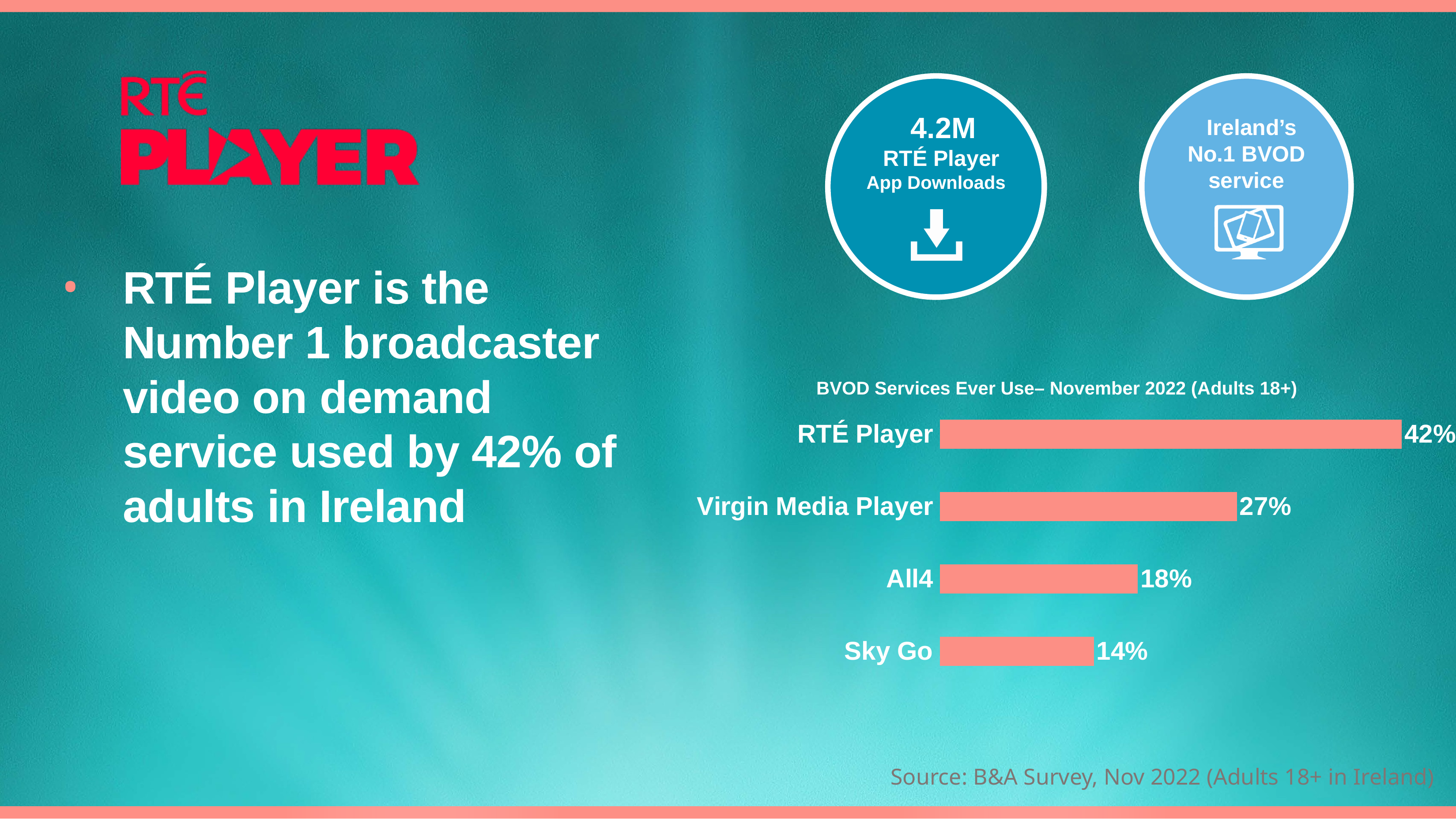
What is the title of the chart on the slide? BVOD Services Ever Use– November 2022 (Adults 18+) Which BVOD service has the highest ever-use value in the chart? RTÉ Player What is the value for RTÉ Player in the BVOD Services Ever Use chart? 42% What is the difference between the values for All4 and Sky Go? 4% What kind of chart is shown on the slide? Bar chart Which BVOD service has the lowest ever-use value in the chart? Sky Go What is the difference between the values for RTÉ Player and Virgin Media Player? 15% What is the value for Sky Go in the chart? 14% How many BVOD services are shown in the chart? 4 What is the value for Virgin Media Player in the chart? 27% What is the value for All4 in the chart? 18% Which has a larger value, Virgin Media Player or All4? Virgin Media Player